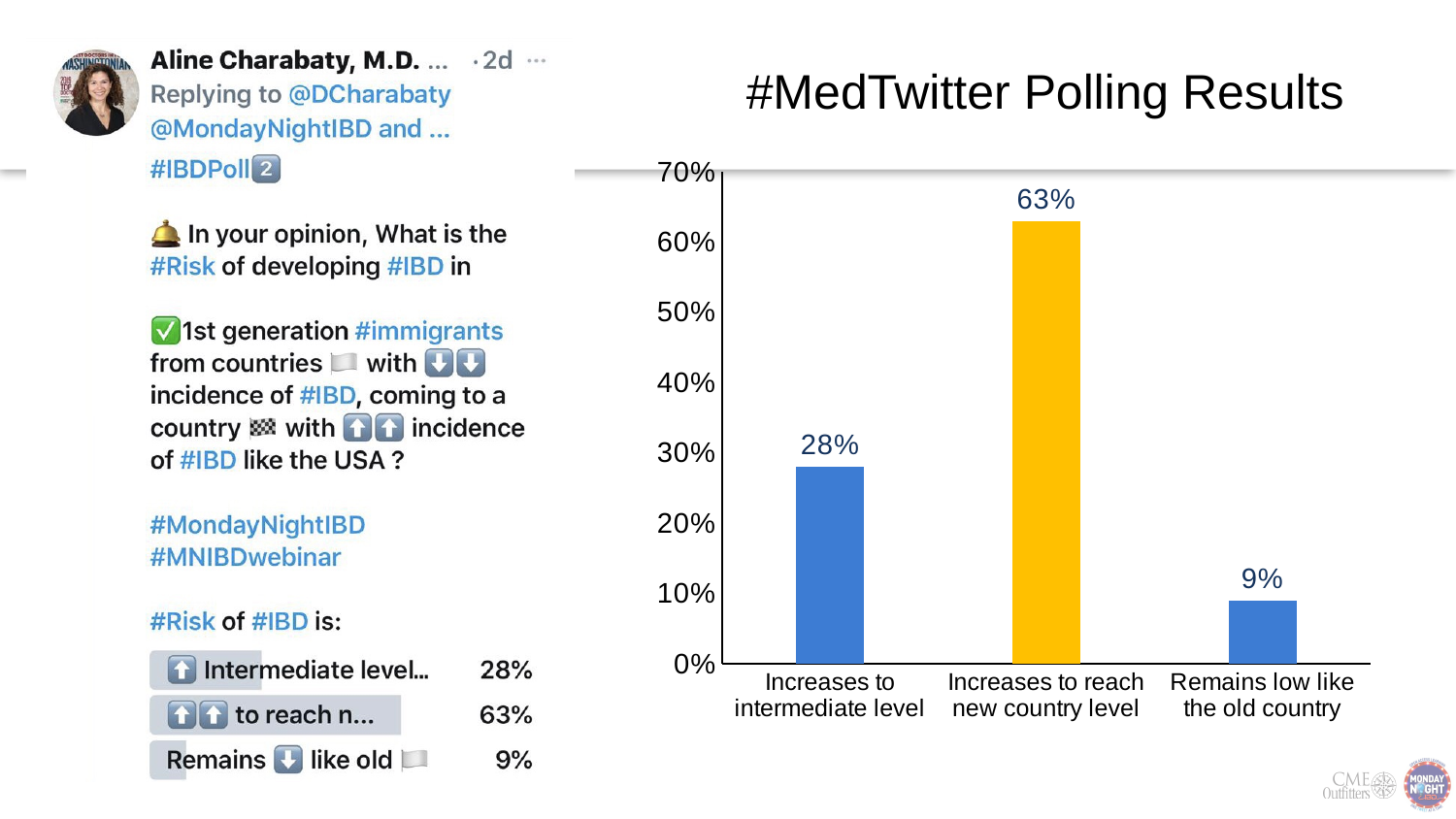
Which is larger: the share for "Increases to intermediate level" or for "Remains low like the old country"? Increases to intermediate level Which response option received the highest share of votes? Increases to reach new country level What percentage of respondents chose "Increases to intermediate level"? 28% What percentage of respondents chose "Remains low like the old country"? 9% Which response option received the lowest share of votes? Remains low like the old country How many response categories are shown in the chart? 3 What percentage of respondents chose "Increases to reach new country level"? 63% What kind of chart is shown on the slide? Bar chart Is the value for "Increases to reach new country level" greater or less than 60%? greater What is the difference between the shares for "Increases to reach new country level" and "Increases to intermediate level"? 35% What is the difference between the shares for "Increases to intermediate level" and "Remains low like the old country"? 19% What is the title of the chart? #MedTwitter Polling Results